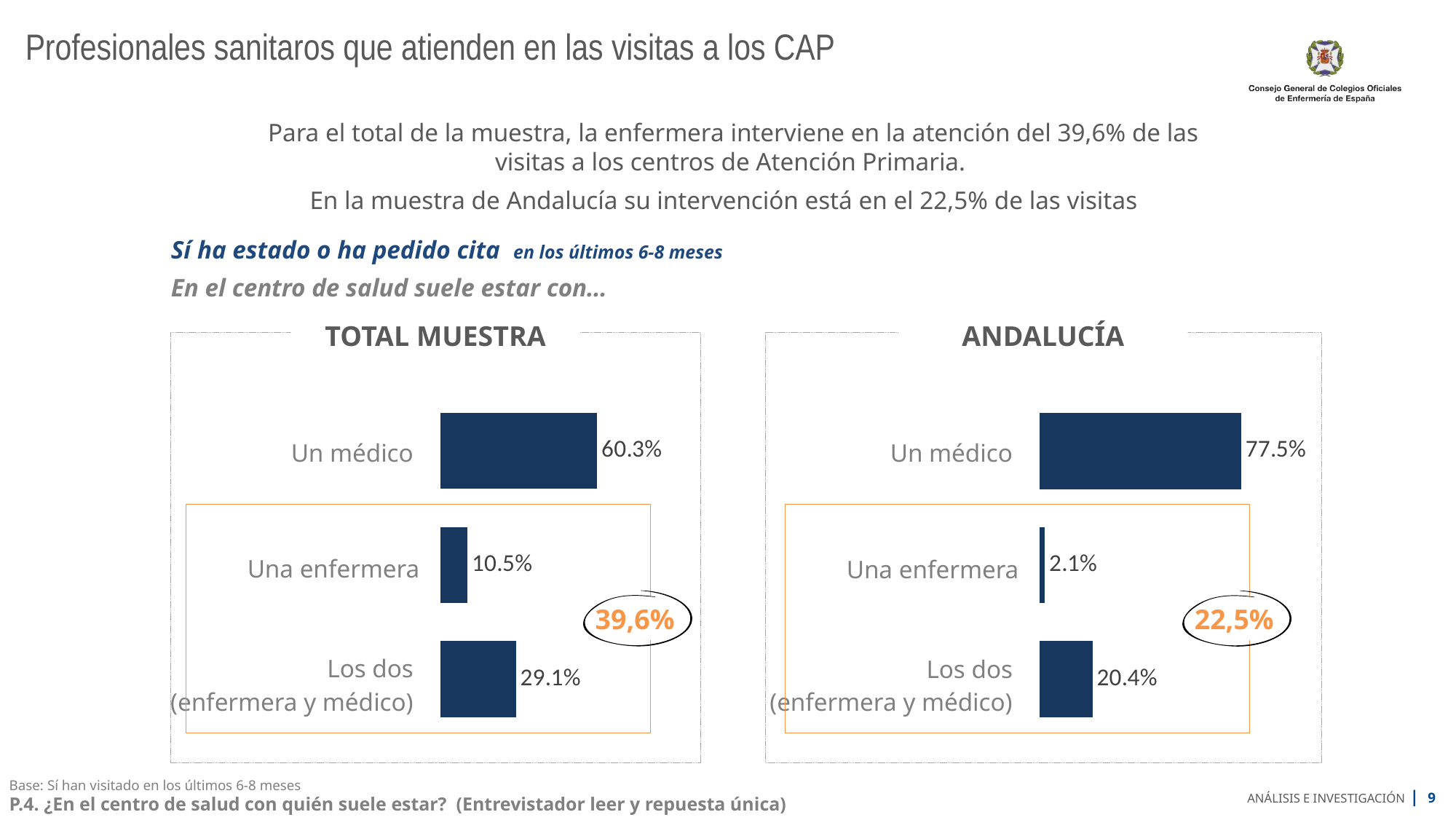
What is the combined value highlighted in the orange circle on the ANDALUCÍA chart? 22,5% In the TOTAL MUESTRA chart, which category has the lowest value? Una enfermera In the ANDALUCÍA chart, what is the value for Los dos (enfermera y médico)? 20.4% How many categories does the TOTAL MUESTRA chart show? 3 In the ANDALUCÍA chart, what is the difference between Un médico and Una enfermera? 75.4% In the TOTAL MUESTRA chart, what is the difference between Un médico and Los dos (enfermera y médico)? 31.2% Which chart has the larger value for Una enfermera, TOTAL MUESTRA or ANDALUCÍA? TOTAL MUESTRA In the ANDALUCÍA chart, which category has the highest value? Un médico In the ANDALUCÍA chart, what is the value for Una enfermera? 2.1% In the TOTAL MUESTRA chart, what is the value for Un médico? 60.3% What kind of chart is the ANDALUCÍA chart? Bar chart In the TOTAL MUESTRA chart, what is the value for Una enfermera? 10.5%